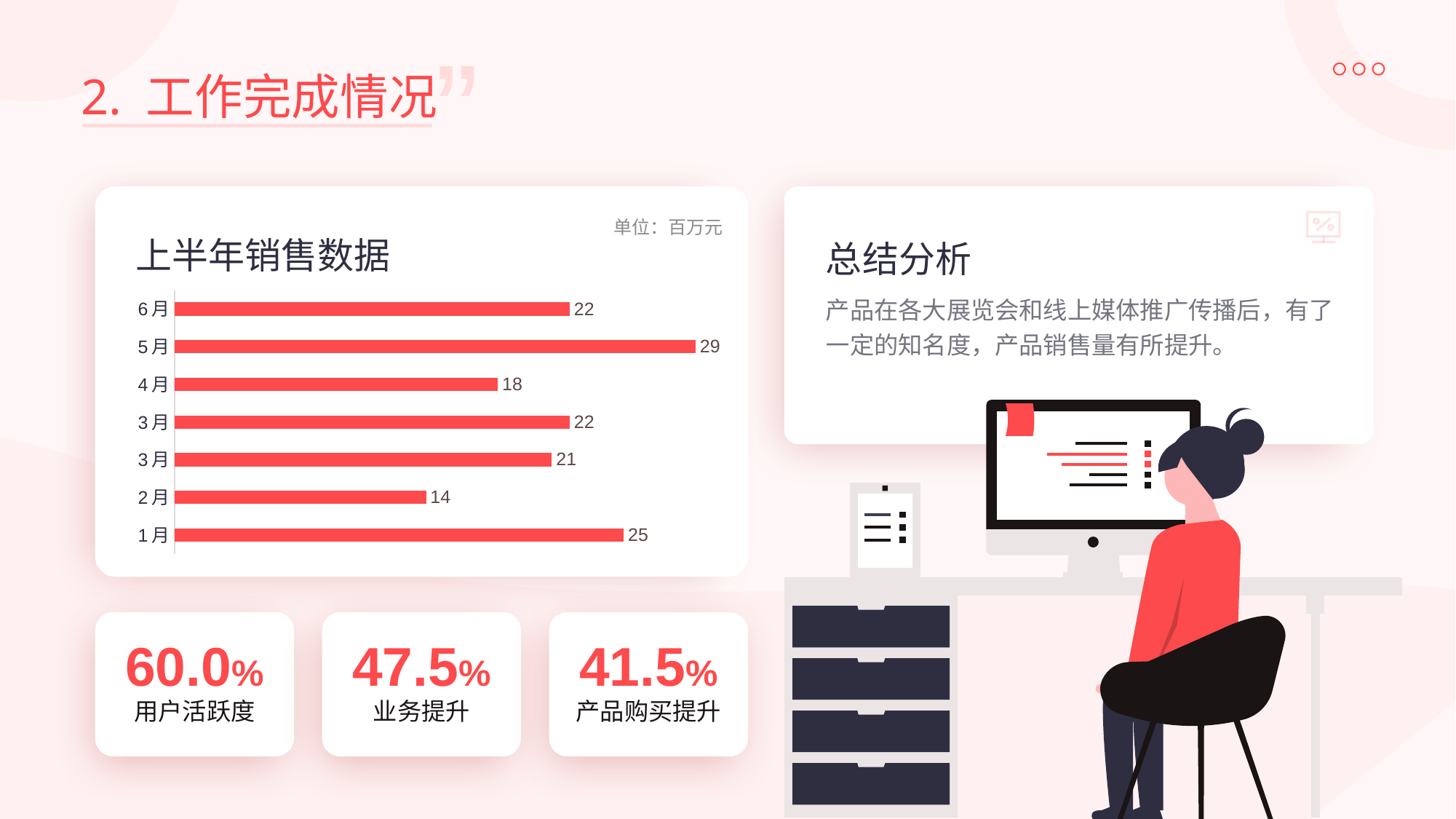
Which month has the highest value in the 上半年销售数据 chart? 5月 What unit is stated for the values in the 上半年销售数据 chart? 百万元 What is the value for 2月 in the 上半年销售数据 chart? 14 Which month has the lowest value in the 上半年销售数据 chart? 2月 What is the value for 6月 in the 上半年销售数据 chart? 22 In the 上半年销售数据 chart, which is larger, the value for 1月 or the value for 4月? 1月 What kind of chart is the 上半年销售数据 chart? Bar chart How many bars are shown in the 上半年销售数据 chart? 7 What is the value for 4月 in the 上半年销售数据 chart? 18 What is the value for 5月 in the 上半年销售数据 chart? 29 What is the difference between the values for 5月 and 2月 in the 上半年销售数据 chart? 15 What is the value for 1月 in the 上半年销售数据 chart? 25